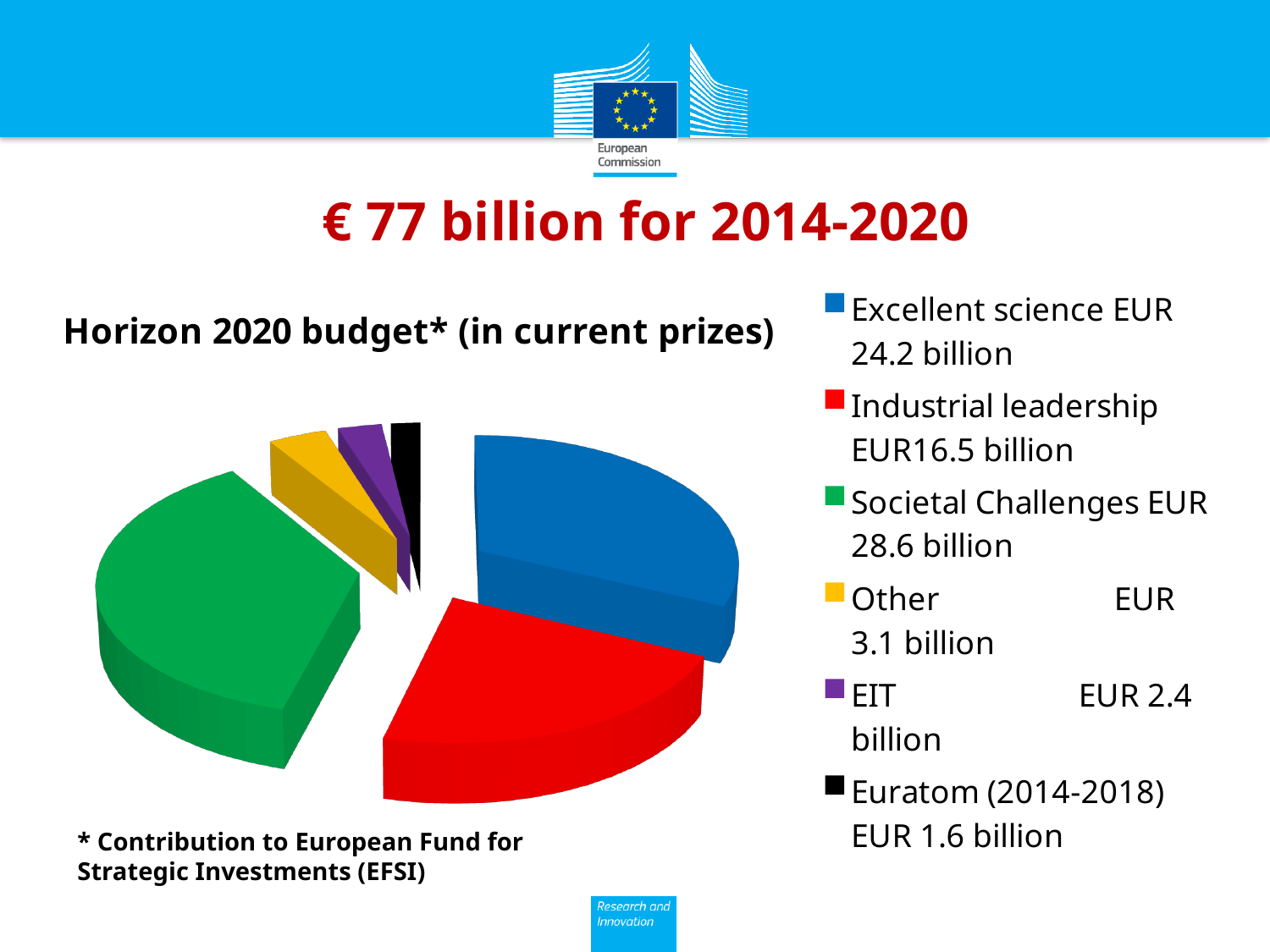
Which category has the smallest budget? Euratom (2014-2018) Which category has the largest budget? Societal Challenges What colour is the Societal Challenges slice? Green What is the budget for EIT? EUR 2.4 billion What kind of chart is shown on the slide? Pie chart What is the title of the pie chart? Horizon 2020 budget* (in current prizes) How many categories does the pie chart show? 6 What is the budget for Societal Challenges? EUR 28.6 billion What is the budget for Euratom (2014-2018)? EUR 1.6 billion How much larger is the Societal Challenges budget than the Excellent science budget? EUR 4.4 billion Which is larger, the budget for Excellent science or for Industrial leadership? Excellent science What is the budget for Excellent science? EUR 24.2 billion